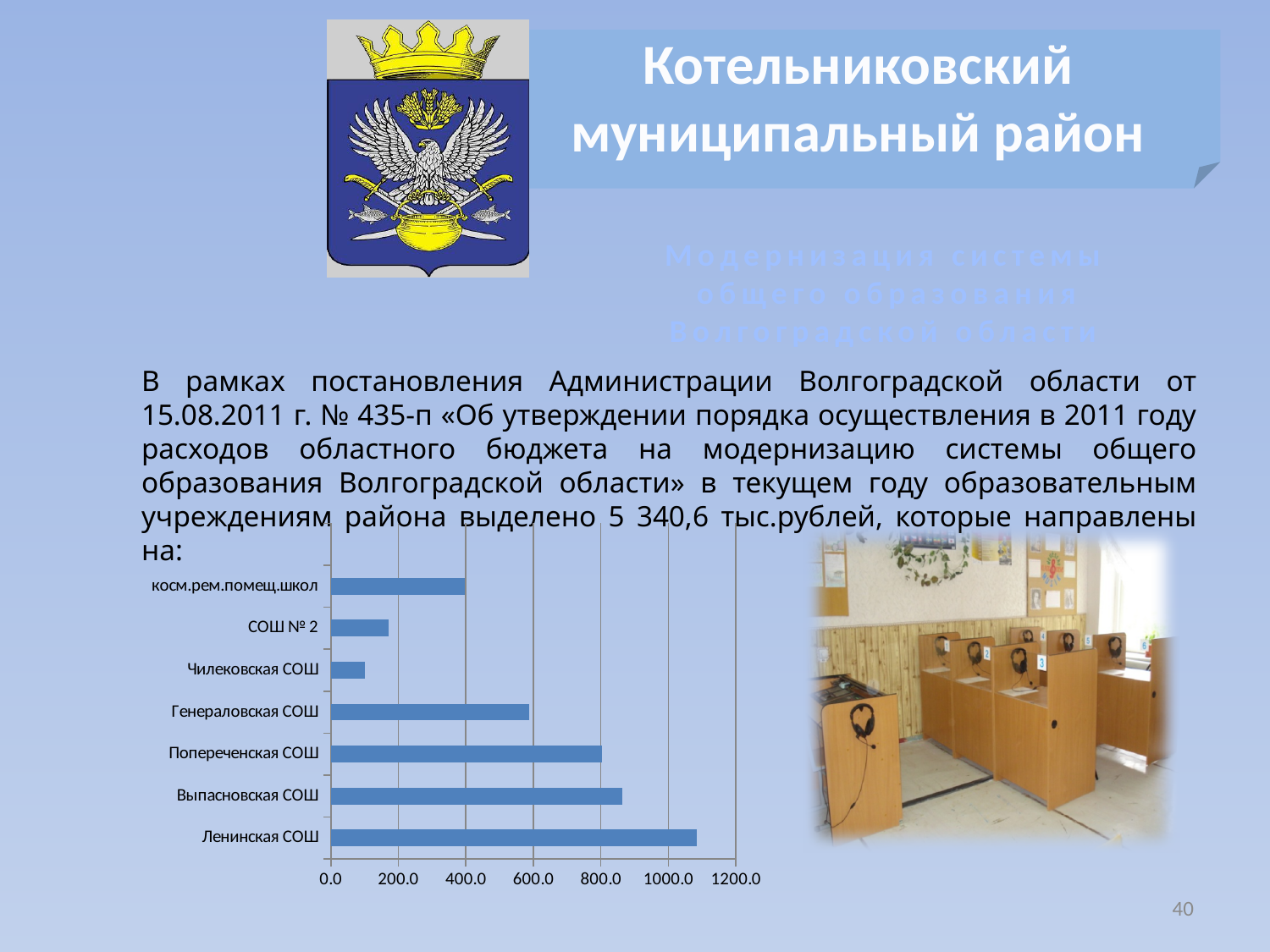
How many categories are plotted in the bar chart? 7 Is the value for Ленинская СОШ greater or less than 1000.0? greater Is the value for Выпасновская СОШ greater or less than 800.0? greater What kind of chart is shown on the slide? bar chart Is the value for косм.рем.помещ.школ greater or less than 200.0? greater What is the highest tick value shown on the horizontal axis of the bar chart? 1200.0 Which category has the highest value in the bar chart? Ленинская СОШ Which category has the lowest value in the bar chart? Чилековская СОШ Which is larger, the value for Выпасновская СОШ or the value for Генераловская СОШ? Выпасновская СОШ Which is larger, the value for СОШ № 2 or the value for Попереченская СОШ? Попереченская СОШ